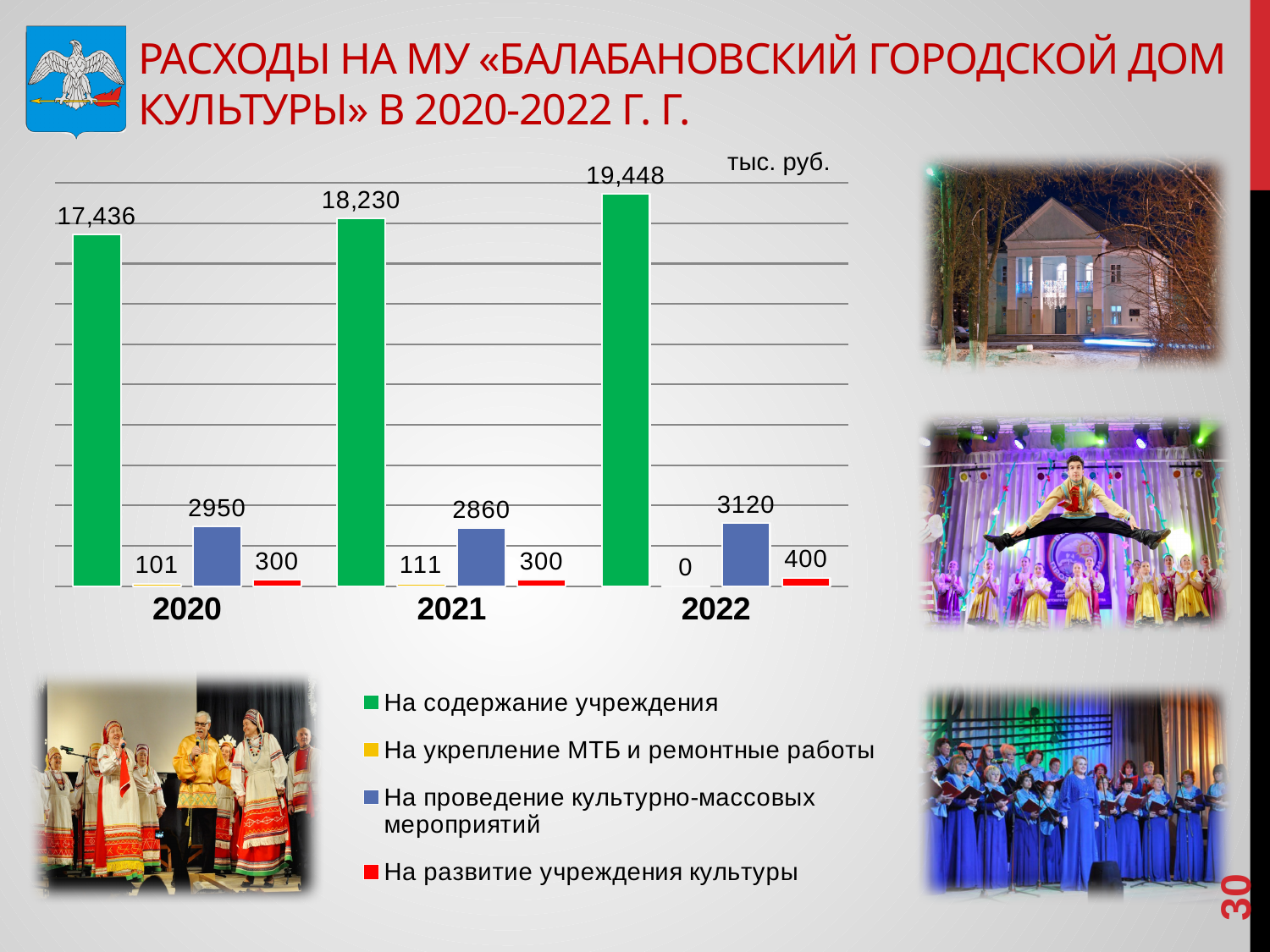
In which year is the value for «На содержание учреждения» the highest? 2022 What is the value for «На укрепление МТБ и ремонтные работы» in 2022? 0 In which year is the value for «На проведение культурно-массовых мероприятий» the lowest? 2021 Does the value for «На содержание учреждения» rise or fall from 2020 to 2022? rise How many years (categories) are shown on the x axis? 3 What is the value for «На содержание учреждения» in 2022? 19,448 What is the value for «На развитие учреждения культуры» in 2022? 400 How many series does the legend list? 4 What is the value for «На проведение культурно-массовых мероприятий» in 2021? 2860 What is the difference between the «На содержание учреждения» values for 2022 and 2020? 2,012 What type of chart is shown on the slide? bar chart Which is larger: «На проведение культурно-массовых мероприятий» in 2020 or in 2022? 2022